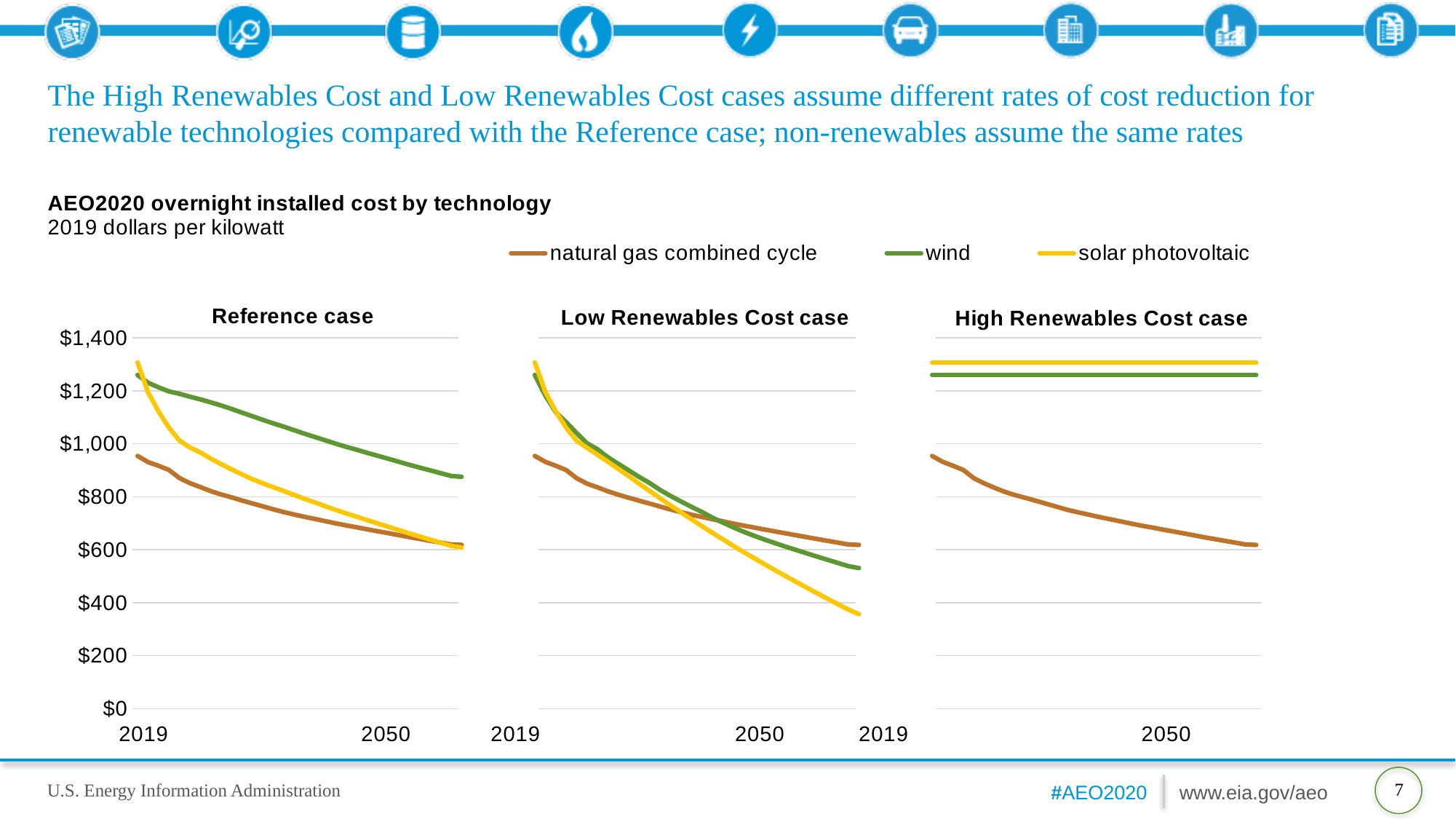
What kind of chart is used for the Reference case panel? line chart In the Low Renewables Cost case chart, is the solar photovoltaic value in 2050 greater or less than $400? less Which series is drawn in green in the legend? wind In the Reference case chart, is the solar photovoltaic value in 2019 greater or less than $1,200? greater In the High Renewables Cost case chart, is the wind value greater or less than $1,200? greater In the Reference case chart, does the wind cost rise or fall from 2019 to 2050? fall In the Low Renewables Cost case chart, which is higher in 2050: wind or solar photovoltaic? wind In the High Renewables Cost case chart, does the solar photovoltaic cost rise, fall, or stay flat from 2019 to 2050? stay flat How many series does the legend list? 3 In the Reference case chart, which is higher in 2050: wind or natural gas combined cycle? wind What unit is the overnight installed cost measured in, according to the subtitle? 2019 dollars per kilowatt